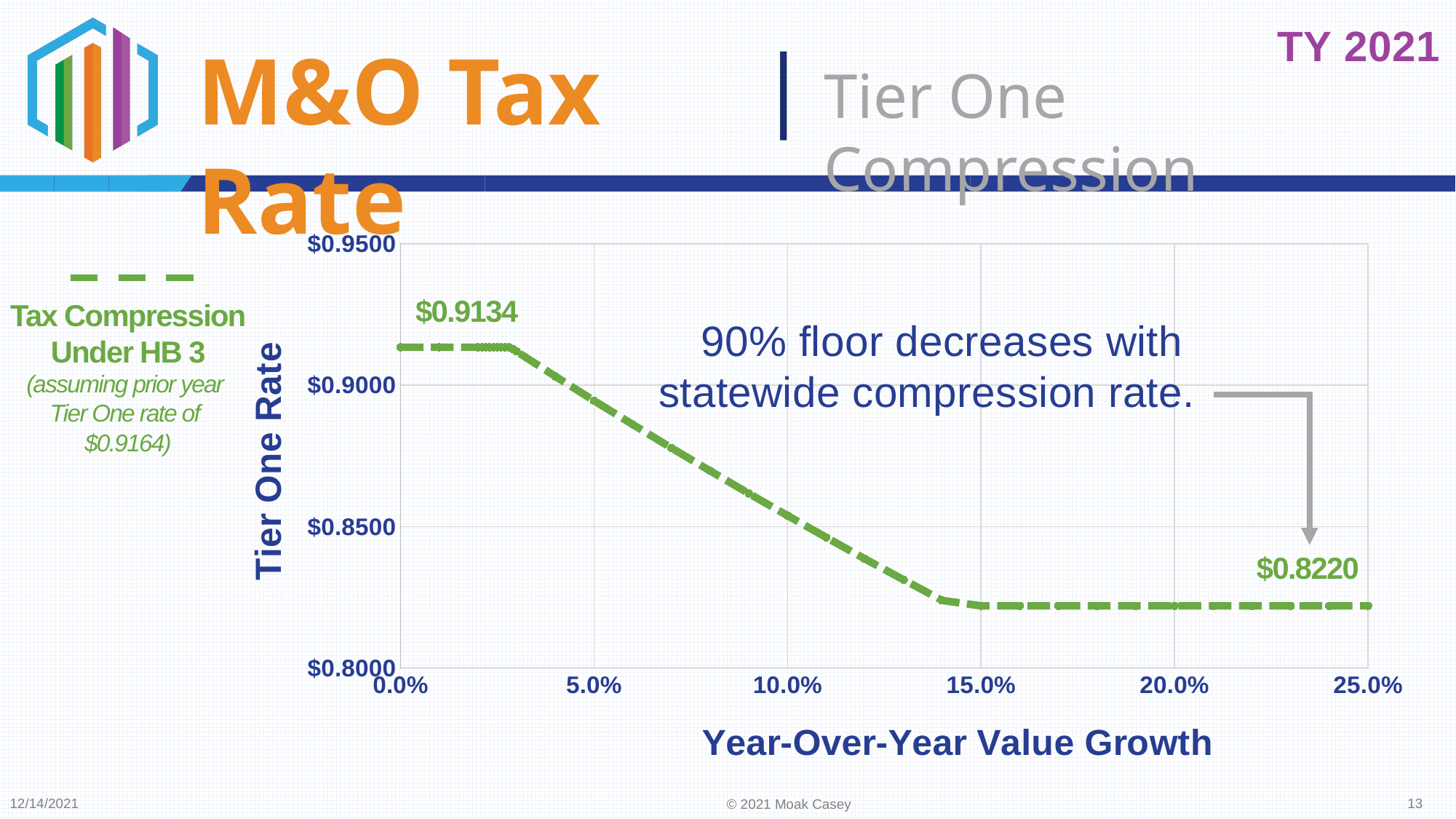
What is the lowest Tier One Rate labelled on the chart? $0.8220 What is the Tier One Rate at 0.0% year-over-year value growth? $0.9134 How many series does the legend list? 1 Does the Tier One Rate rise or fall as year-over-year value growth increases from 0.0% to 25.0%? fall What is the Tier One Rate at 25.0% year-over-year value growth? $0.8220 What is the highest Tier One Rate labelled on the chart? $0.9134 Which is larger, the Tier One Rate at 0.0% growth or at 25.0% growth? 0.0% growth What kind of chart is shown on the slide? line chart What is the title of the x axis? Year-Over-Year Value Growth Is the Tier One Rate at 20.0% growth greater or less than $0.8500? less Is the Tier One Rate at 5.0% growth greater or less than $0.8500? greater What is the difference between the Tier One Rate at 0.0% growth and at 25.0% growth? $0.0914